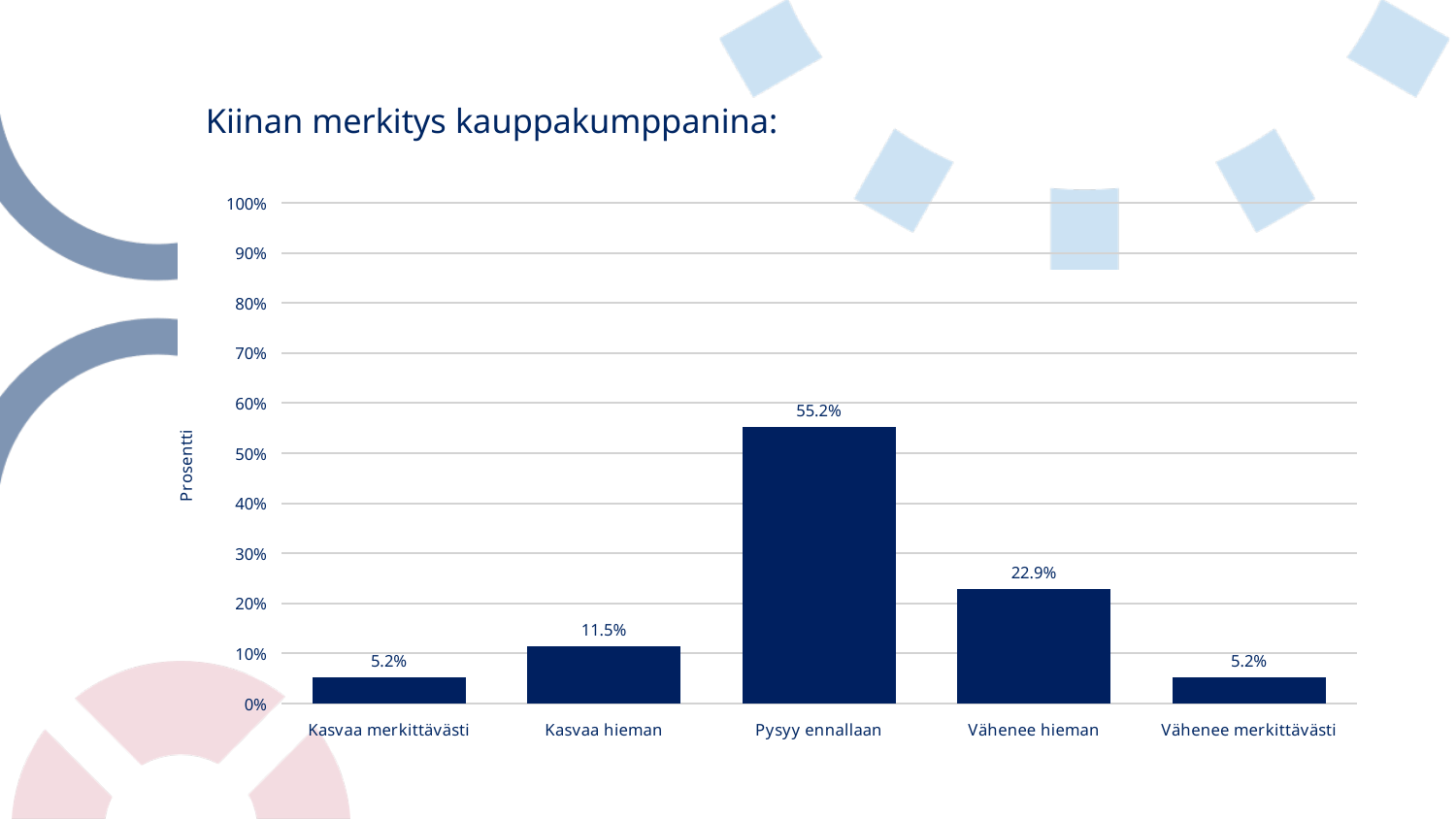
What is the value for Kasvaa merkittävästi? 5.2% Which is larger, the value for Kasvaa hieman or the value for Vähenee hieman? Vähenee hieman What is the value for Pysyy ennallaan? 55.2% Which category has the highest value? Pysyy ennallaan How many categories are shown on the x axis? 5 What is the label of the y axis? Prosentti What kind of chart is shown on the slide? bar chart What is the value for Kasvaa hieman? 11.5% What is the value for Vähenee hieman? 22.9% Is the value for Pysyy ennallaan greater or less than 50%? greater What is the difference between the values for Kasvaa hieman and Kasvaa merkittävästi? 6.3% What is the difference between the values for Pysyy ennallaan and Vähenee hieman? 32.3%